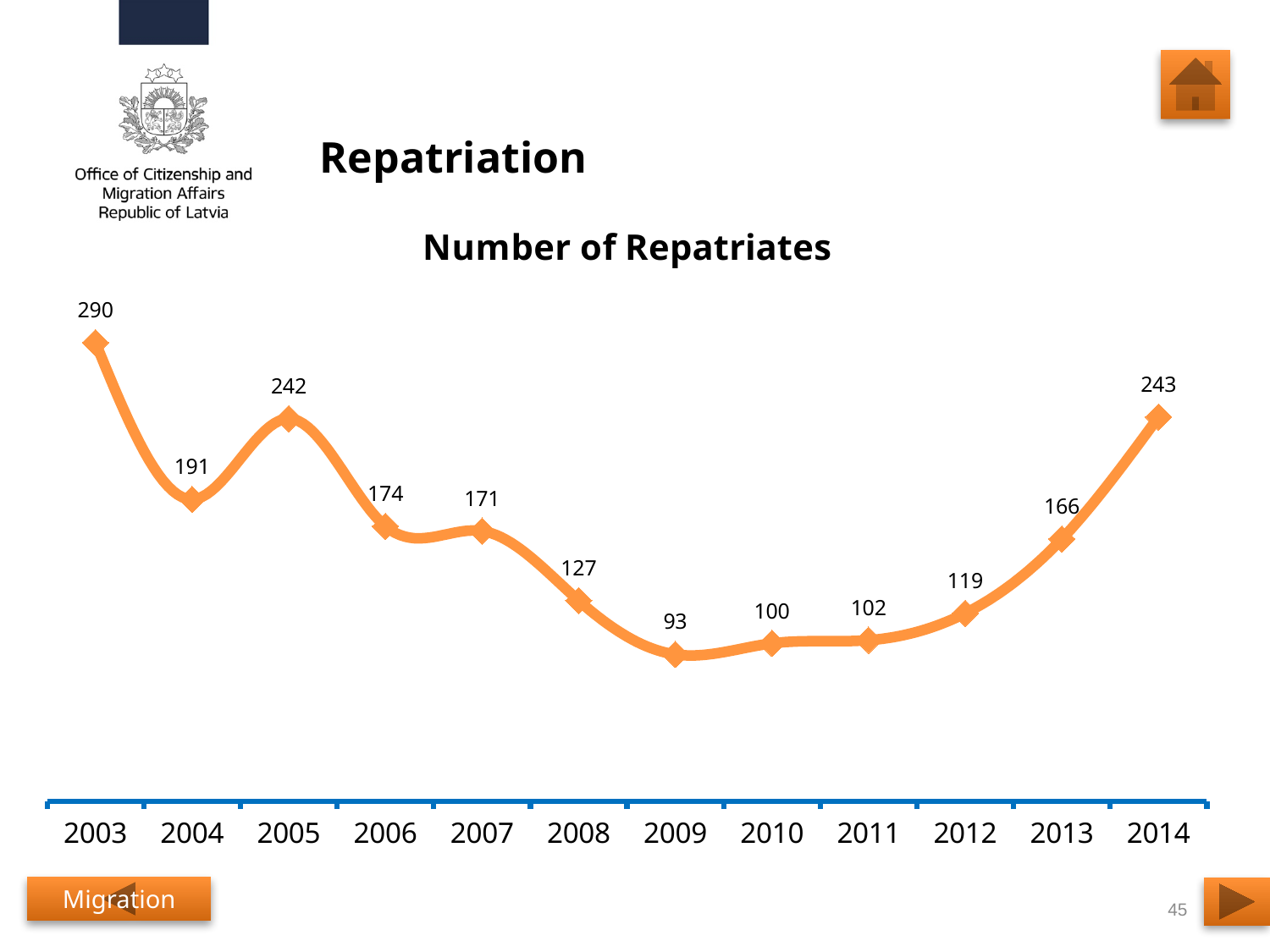
Which year has the highest number of repatriates? 2003 What is the number of repatriates in 2014? 243 Which year has the lowest number of repatriates? 2009 What is the title of the chart? Number of Repatriates What is the difference between the number of repatriates in 2014 and 2013? 77 What is the number of repatriates in 2003? 290 How many years are shown on the x axis of the chart? 12 What kind of chart is shown on the slide? Line chart What is the number of repatriates in 2009? 93 What is the difference between the number of repatriates in 2003 and 2004? 99 Which year had more repatriates, 2005 or 2014? 2014 Do the values rise or fall from 2009 to 2014? Rise